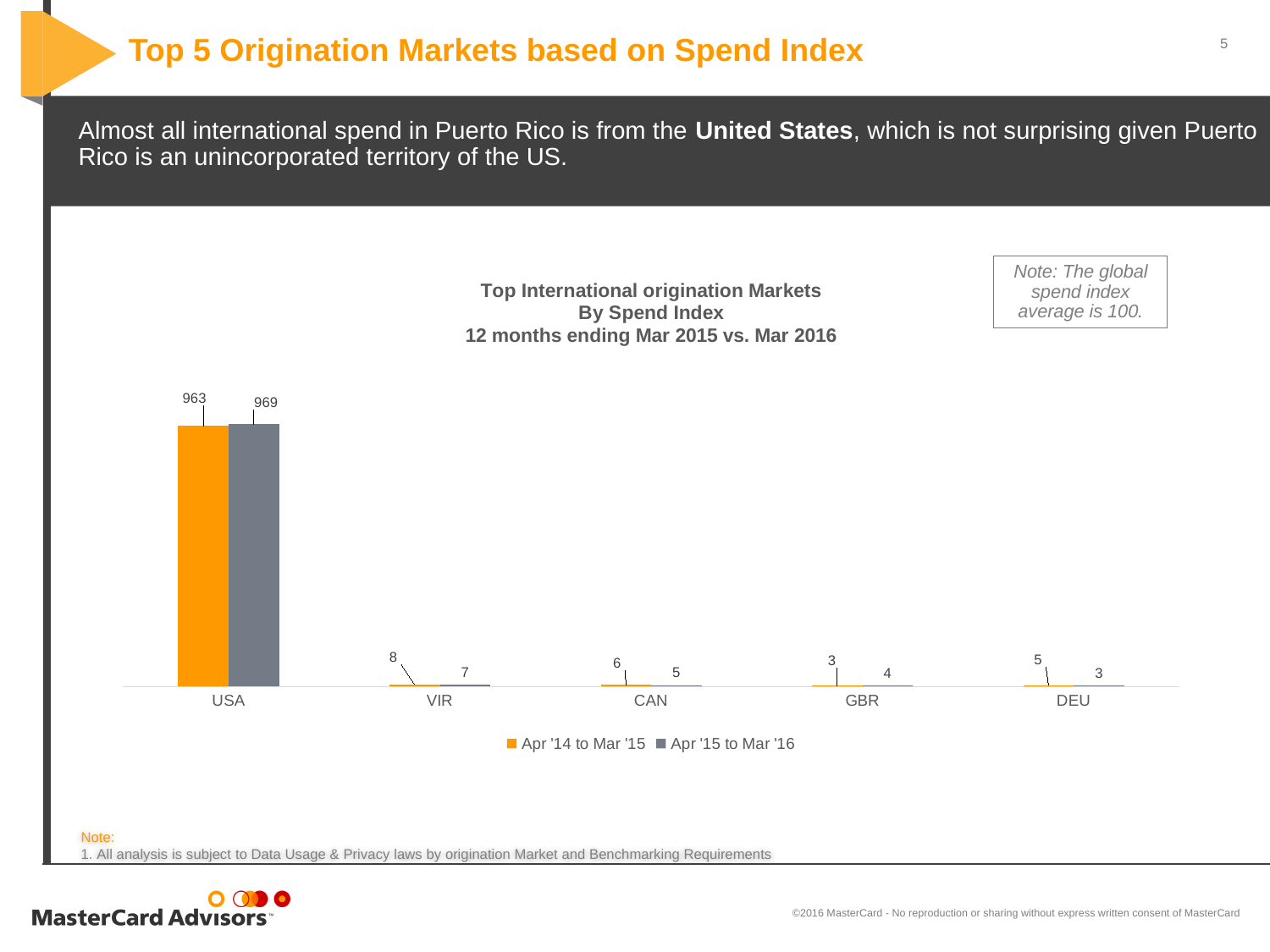
What type of chart is shown on the slide? Bar chart Which origination market has the highest spend index in the Apr '15 to Mar '16 period? USA Which origination market has the lowest spend index in the Apr '14 to Mar '15 period? GBR What is the difference between the USA spend index in Apr '15 to Mar '16 and Apr '14 to Mar '15? 6 How many origination markets are shown on the chart? 5 How many series does the legend list? 2 What is the spend index for VIR in the Apr '14 to Mar '15 period? 8 What is the spend index for CAN in the Apr '15 to Mar '16 period? 5 Which is larger for GBR: the Apr '14 to Mar '15 value or the Apr '15 to Mar '16 value? Apr '15 to Mar '16 What is the spend index for USA in the Apr '15 to Mar '16 period? 969 What is the spend index for USA in the Apr '14 to Mar '15 period? 963 What is the spend index for DEU in the Apr '15 to Mar '16 period? 3